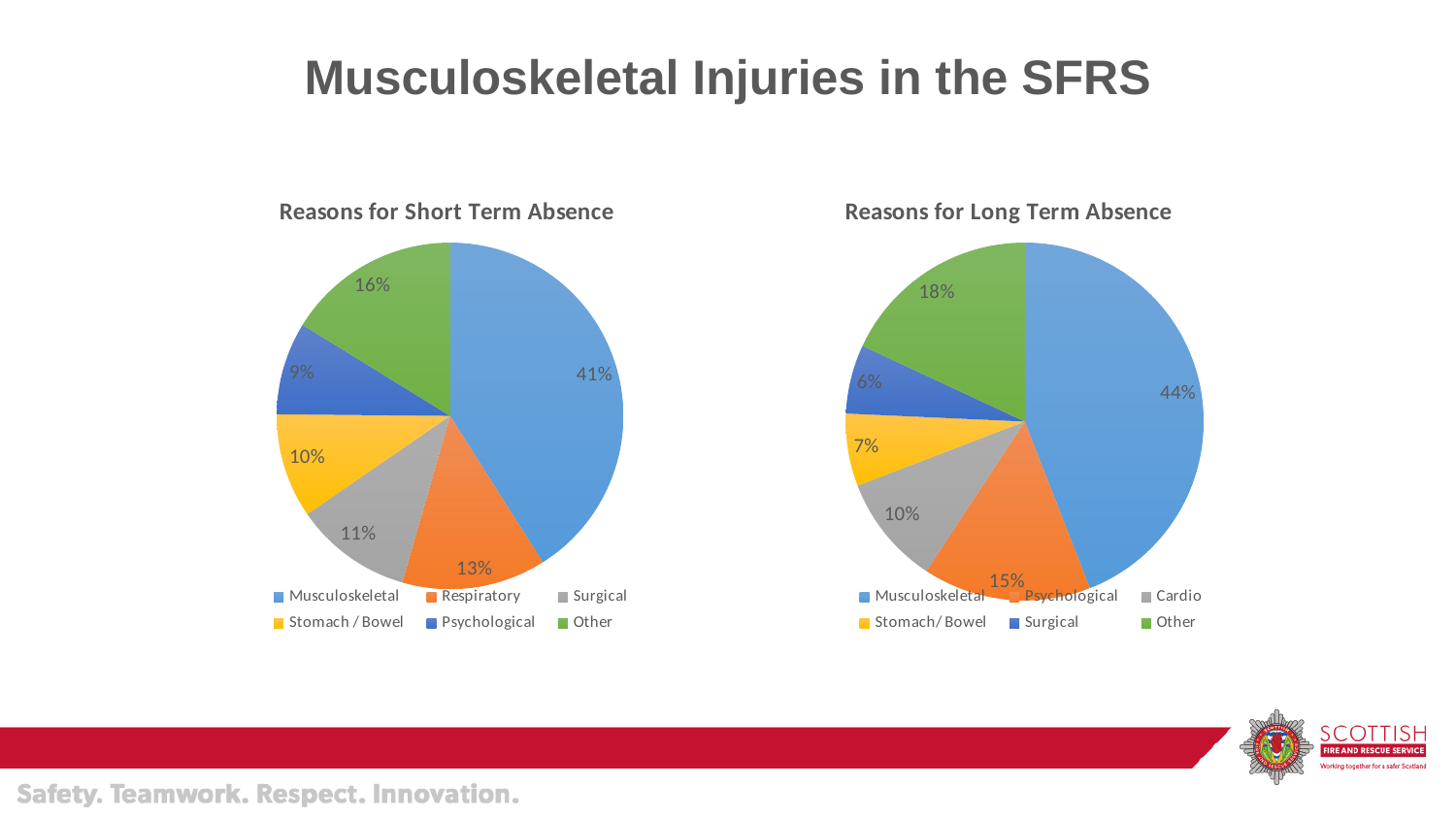
In the 'Reasons for Long Term Absence' chart, which is larger, Stomach/Bowel or Cardio? Cardio In the 'Reasons for Long Term Absence' chart, what share is Psychological? 15% In the 'Reasons for Long Term Absence' chart, which category has the smallest slice? Surgical What type of chart is 'Reasons for Long Term Absence'? Pie chart In the 'Reasons for Short Term Absence' chart, what share is Stomach / Bowel? 10% In the 'Reasons for Long Term Absence' chart, which category has the largest slice? Musculoskeletal In the 'Reasons for Long Term Absence' chart, what is the difference between the Other and Cardio shares? 8% In the 'Reasons for Short Term Absence' chart, which is larger, Surgical or Other? Other In the 'Reasons for Short Term Absence' chart, what is the difference between the Musculoskeletal and Respiratory shares? 28% In the 'Reasons for Short Term Absence' chart, what share is Musculoskeletal? 41% How many categories does the 'Reasons for Short Term Absence' chart show? 6 In the 'Reasons for Short Term Absence' chart, which category has the smallest slice? Psychological